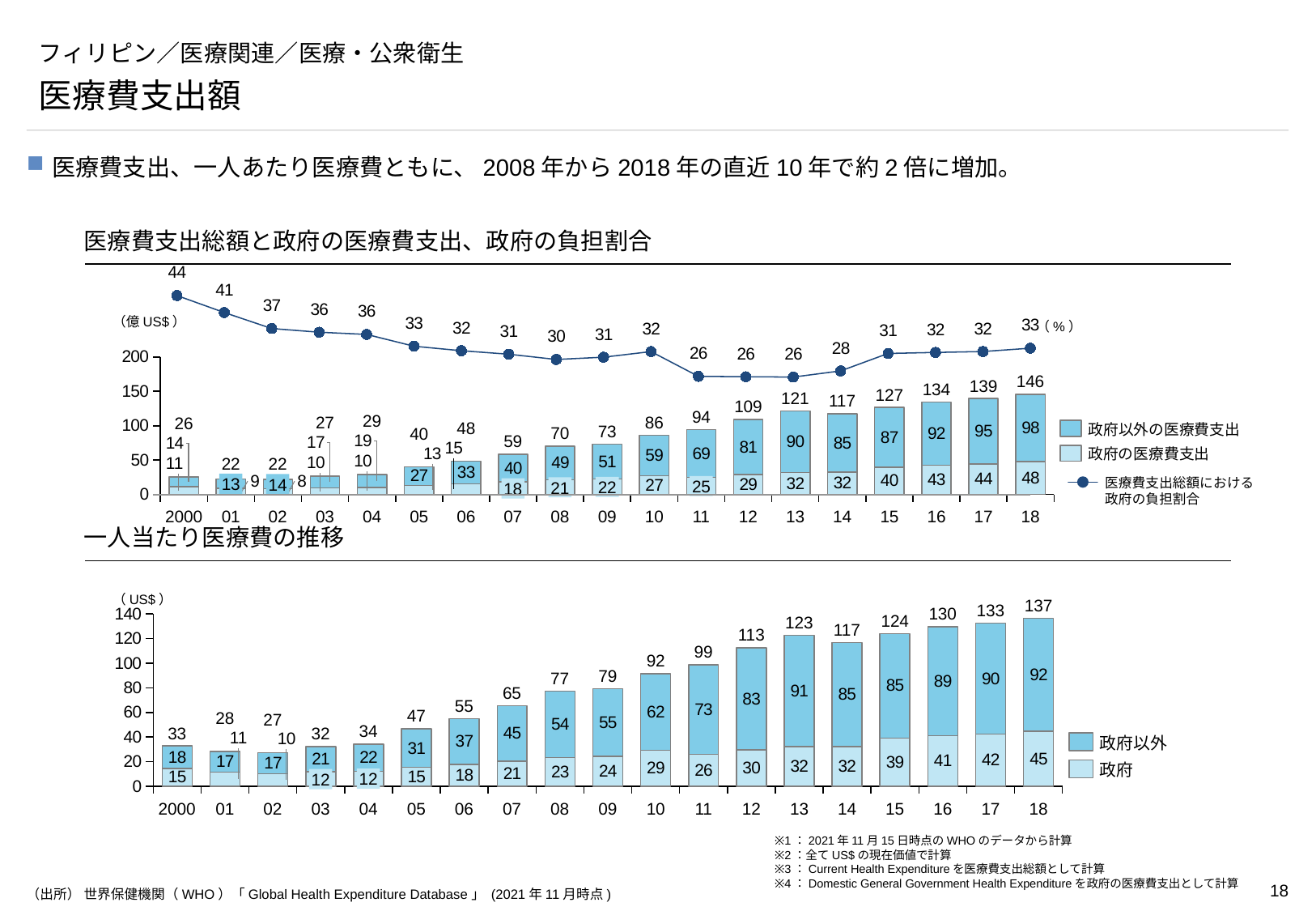
In the top chart, in which year is the 政府の負担割合 line at its highest? 2000 In the bottom chart, which year has the lowest total per-capita health expenditure? 02 What kind of chart is the bottom chart (一人当たり医療費の推移)? stacked bar chart In the bottom chart (一人当たり医療費の推移), what is the total per-capita health expenditure labelled for 2018? 137 In the top chart, how many entries does the legend list? 3 In the top chart, what is the difference between the 政府以外の医療費支出 and 政府の医療費支出 values in 2018? 50 In the top chart (医療費支出総額と政府の医療費支出、政府の負担割合), what is the total health expenditure value labelled for 2018? 146 In the bottom chart, what is the 政府 value for 2000? 15 In the top chart, what is the 政府の医療費支出 value for 2018? 48 In the bottom chart, is the 政府以外 value for 2018 larger or smaller than the 政府 value for 2018? larger In the bottom chart, how many years are plotted along the x axis? 19 In the top chart, what is the 政府の負担割合 (%) shown for 2000? 44